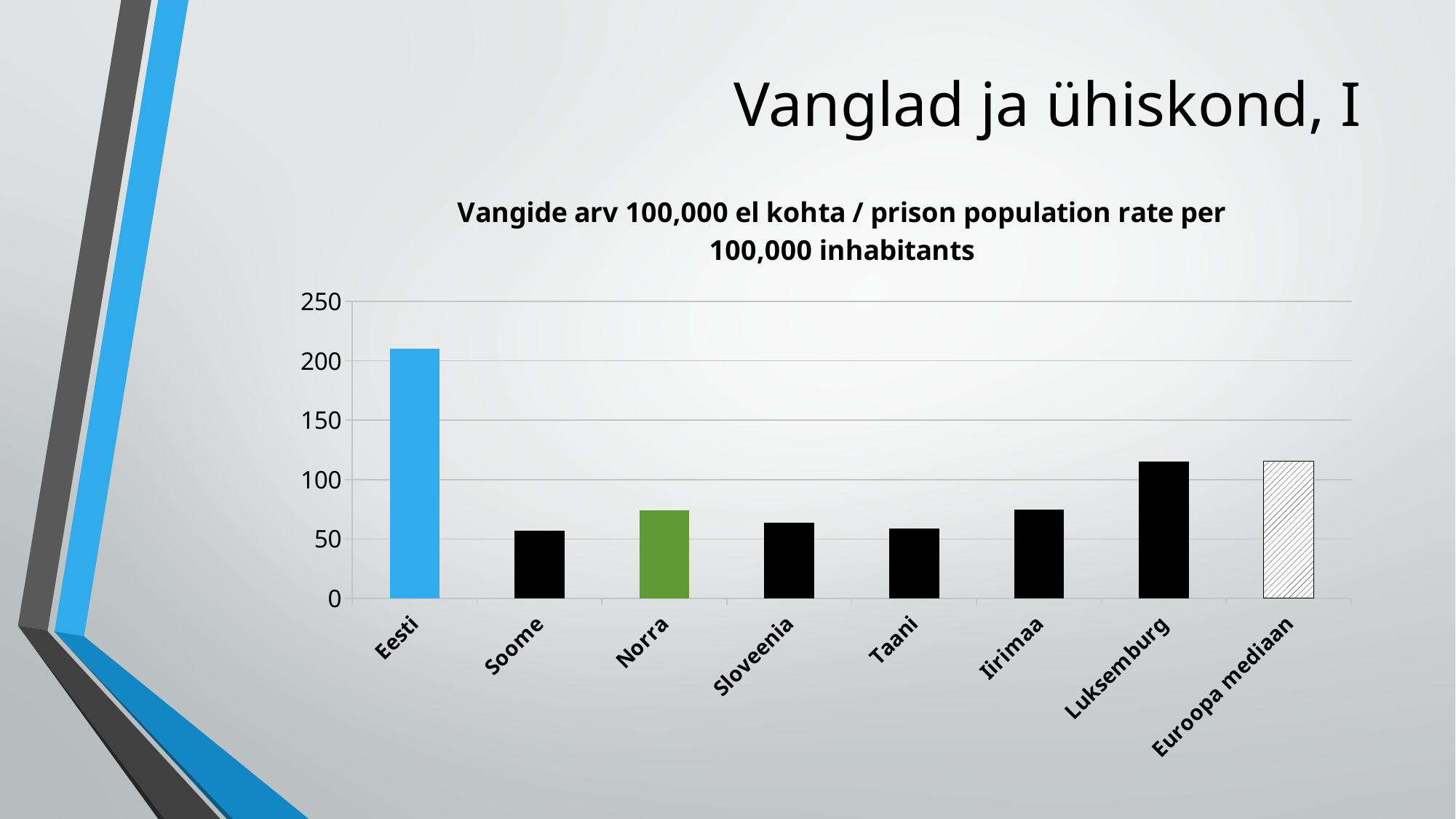
What is the title of the chart? Vangide arv 100,000 el kohta / prison population rate per 100,000 inhabitants Is the value for Norra greater or less than 100? less Which has a larger value, Luksemburg or Sloveenia? Luksemburg How many categories are shown on the x axis of the chart? 8 Which has a larger value, Eesti or Soome? Eesti Is the value for Luksemburg greater or less than 100? greater Is the value for Soome greater or less than 100? less What kind of chart is shown on the slide? bar chart Which category has the highest prison population rate in the chart? Eesti